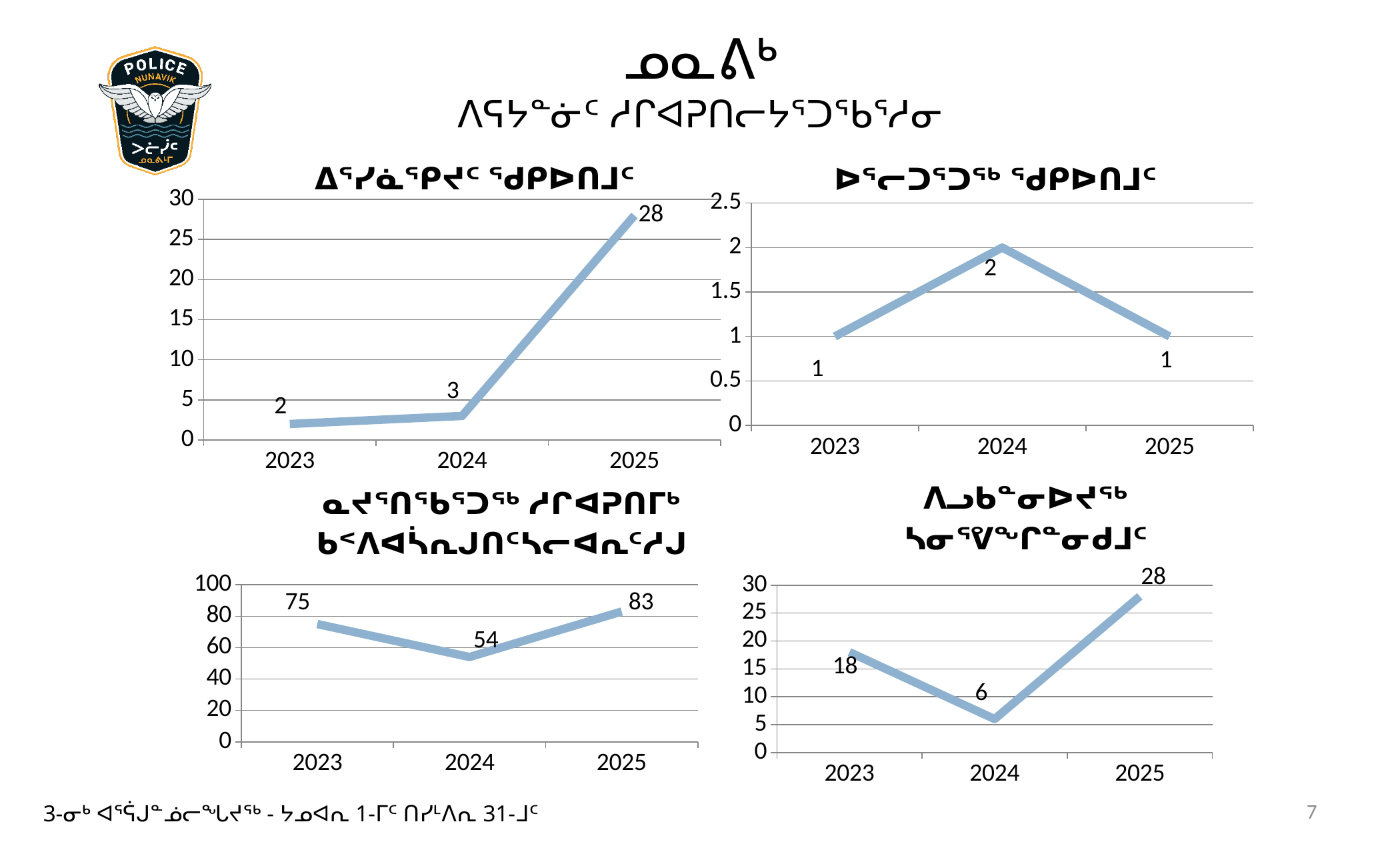
In the bottom-right chart, what is the value for 2024? 6 In the bottom-right chart, which is larger, the value for 2023 or the value for 2024? 2023 What kind of chart is the top-left chart? line chart In the top-left chart, what is the value for 2025? 28 In the bottom-left chart, which year has the lowest value? 2024 In the bottom-left chart, what is the value for 2023? 75 In the top-left chart, what is the difference between the 2025 and 2024 values? 25 In the top-left chart, what is the value for 2023? 2 In the top-right chart, what is the value for 2024? 2 In the bottom-left chart, what is the difference between the 2025 and 2023 values? 8 How many data points are plotted in the bottom-right chart? 3 In the top-right chart, which year has the highest value? 2024